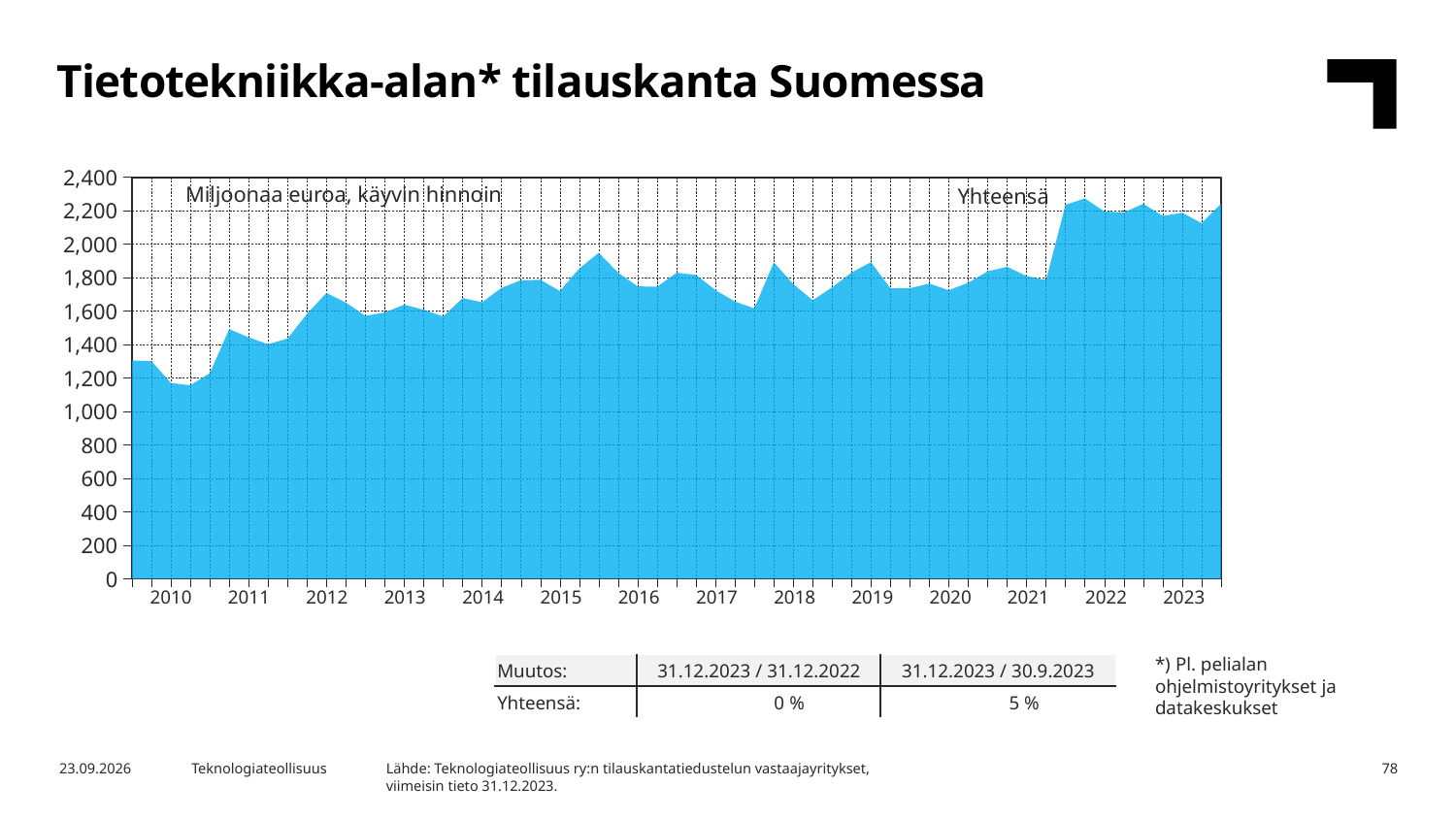
Is the value in 2017 greater or less than 2,000? less What kind of chart is shown on the slide? Area chart How many years are labelled on the x axis of the chart? 14 Is the value in 2022 greater or less than 2,000? greater In what unit are the values of the chart expressed, according to the label inside the plot area? Miljoonaa euroa, käyvin hinnoin Is the value in 2010 greater or less than 1,400? less According to the table below the chart, what is the change (Muutos) for Yhteensä between 31.12.2022 and 31.12.2023? 0 % Overall, do the values rise or fall from 2010 to 2023? rise Which year on the x axis shows the lowest values of the order backlog? 2010 What is the name of the series shown in the chart? Yhteensä